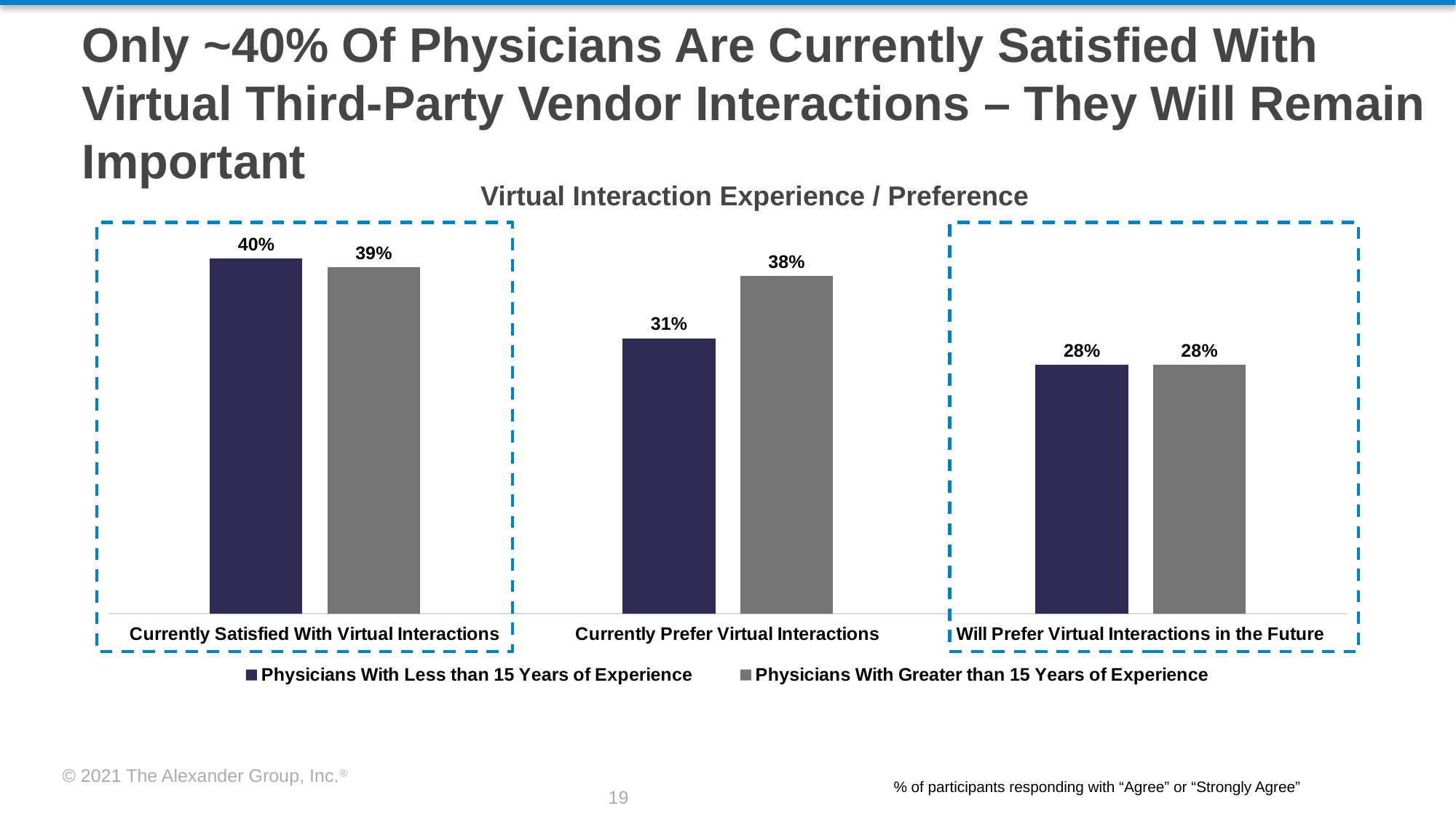
What is the value for Physicians With Greater than 15 Years of Experience in the Currently Prefer Virtual Interactions category? 38% How many categories are shown on the x axis? 3 Which category has the lowest value for Physicians With Greater than 15 Years of Experience? Will Prefer Virtual Interactions in the Future Which category has the highest value for Physicians With Less than 15 Years of Experience? Currently Satisfied With Virtual Interactions What is the value for Physicians With Less than 15 Years of Experience in the Currently Satisfied With Virtual Interactions category? 40% How many series does the legend list? 2 What is the value for Physicians With Less than 15 Years of Experience in the Will Prefer Virtual Interactions in the Future category? 28% What is the difference between the two series in the Currently Prefer Virtual Interactions category? 7% In the Currently Prefer Virtual Interactions category, which series has the larger value? Physicians With Greater than 15 Years of Experience What kind of chart is shown on the slide? Bar chart What is the title of the chart? Virtual Interaction Experience / Preference Do the values for Physicians With Less than 15 Years of Experience rise or fall across the categories from left to right? Fall